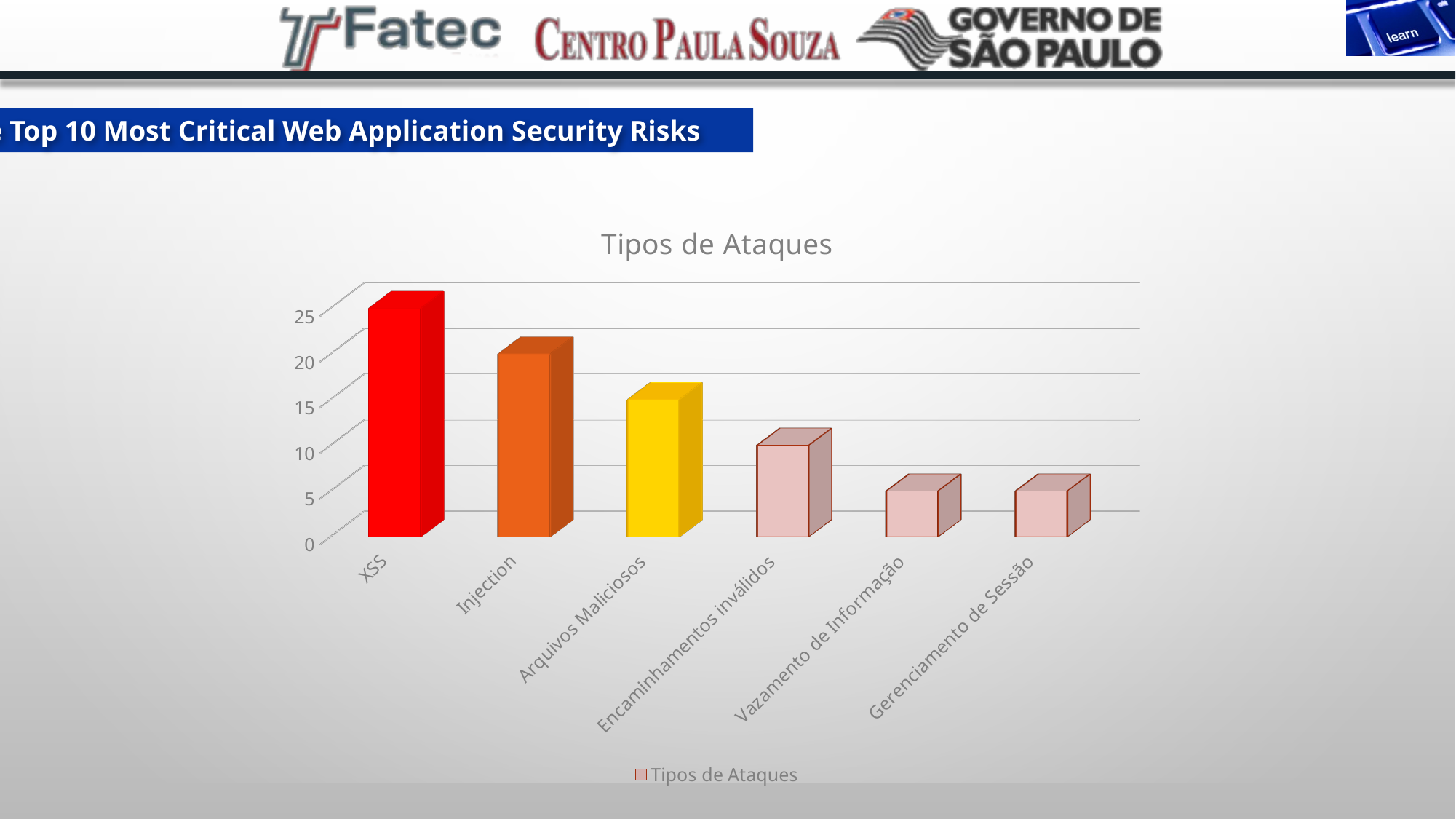
Do the bar values rise or fall moving from left to right along the x axis? fall What is the title of the chart? Tipos de Ataques How many categories are plotted on the x axis of the chart? 6 Is the value for Encaminhamentos inválidos greater or less than 15? less Is the value for Injection greater or less than 15? greater Which has the larger value, XSS or Injection? XSS Is the value for Vazamento de Informação greater or less than 10? less What kind of chart is shown on the slide? bar chart How many series does the chart legend list? 1 Which category has the highest bar in the chart? XSS Which has the larger value, Injection or Arquivos Maliciosos? Injection